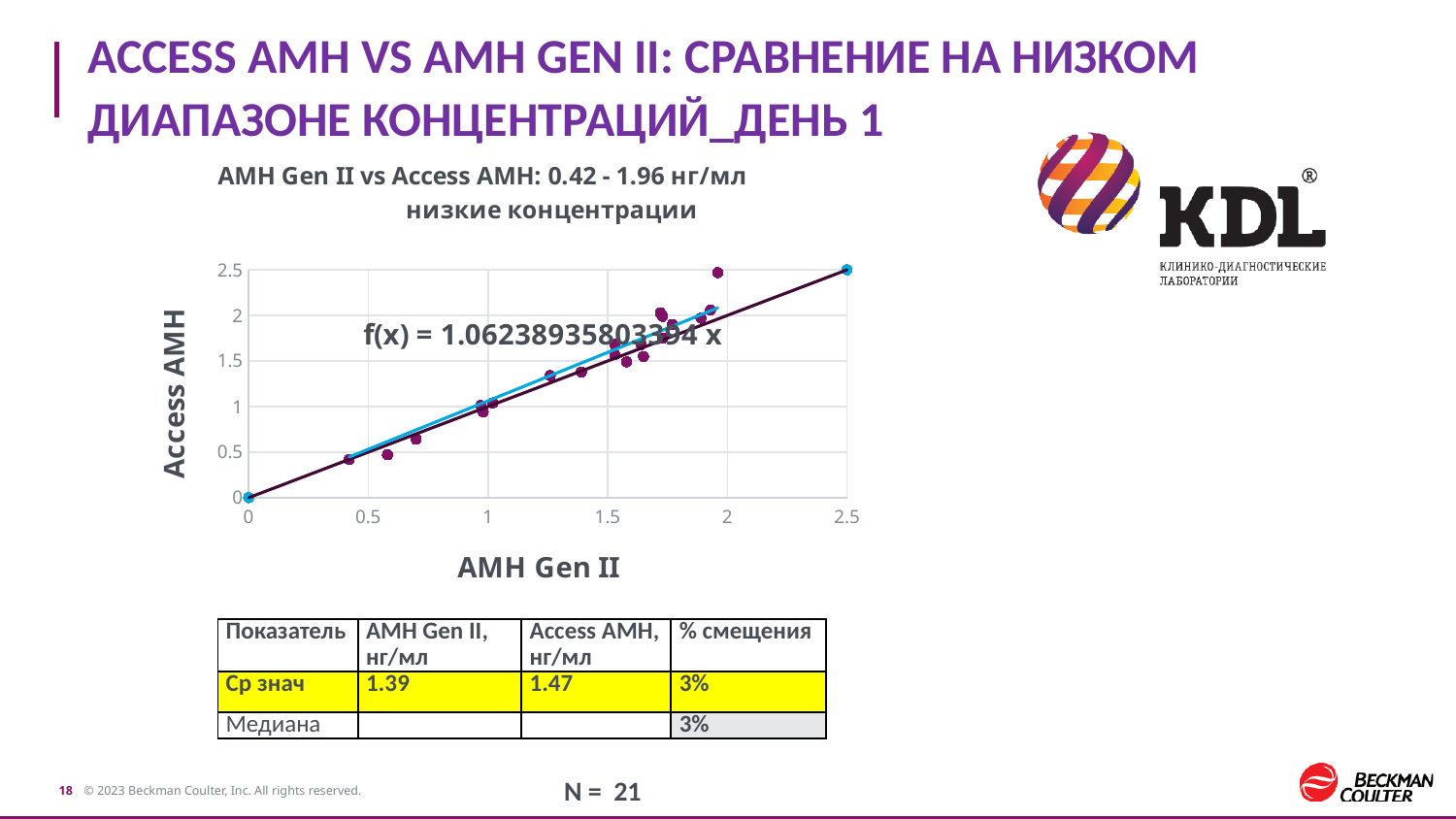
What is the title of the y axis of the chart? Access AMH How many tick labels are shown on the x axis of the chart? 6 Is the AMH Gen II value of the lowest plotted point greater or less than 0.5? less Is the Access AMH value of the highest plotted point greater or less than 2? greater What is the slope of the fitted line f(x) shown on the chart, rounded to two decimal places? 1.06 What is the highest tick value shown on the y axis of the chart? 2.5 What is the interval between consecutive tick marks on the x axis of the chart? 0.5 Do the plotted Access AMH values rise or fall as AMH Gen II increases along the x axis? rise What is the title of the x axis of the chart? AMH Gen II What kind of chart is shown on the slide? scatter chart